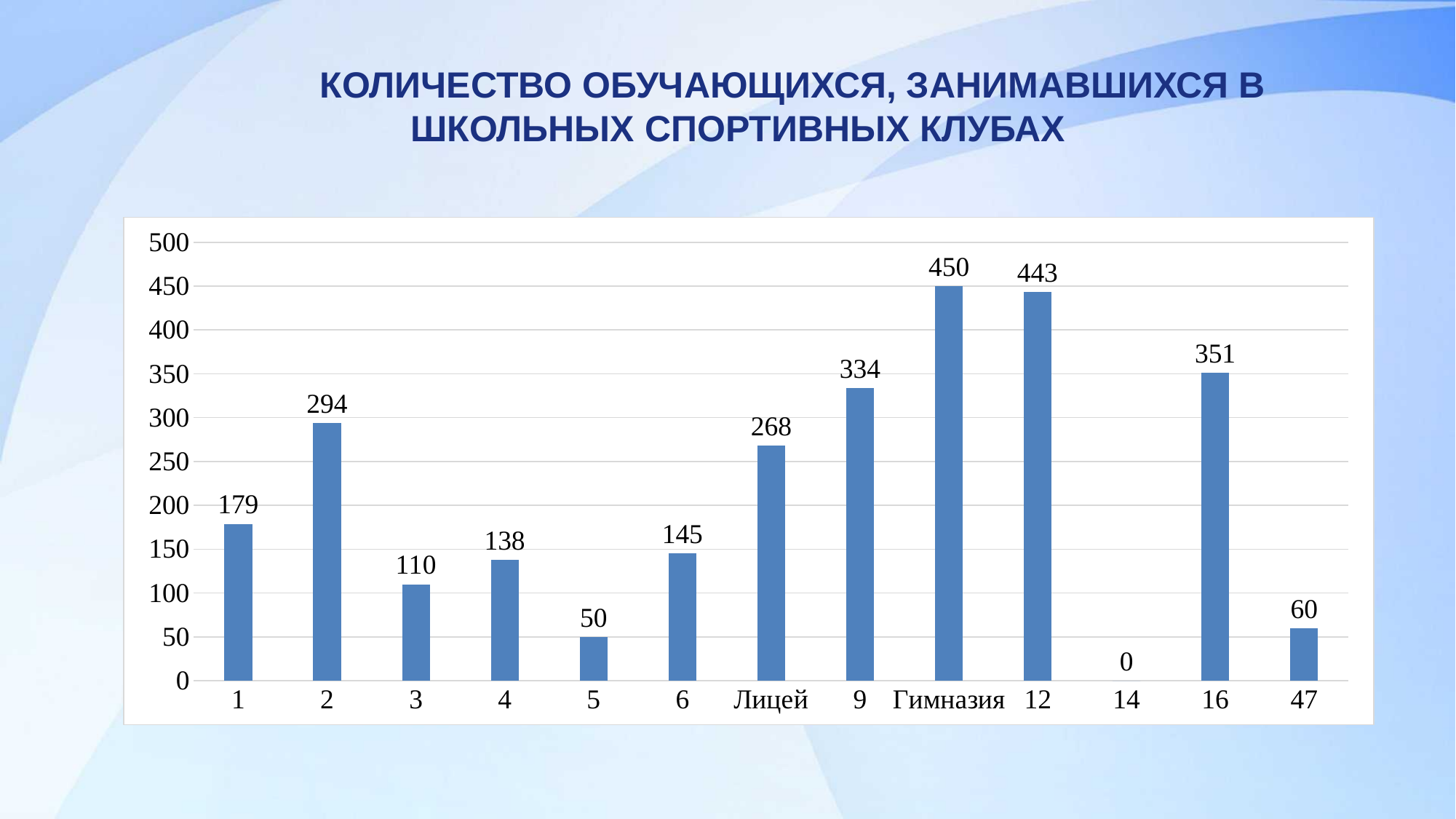
What is the value for Лицей? 268 What is the difference between the values for Гимназия and category 12? 7 What is the title of the slide? КОЛИЧЕСТВО ОБУЧАЮЩИХСЯ, ЗАНИМАВШИХСЯ В ШКОЛЬНЫХ СПОРТИВНЫХ КЛУБАХ How many categories are shown on the x axis? 13 Is the value for category 9 greater or less than 300? greater What is the value for category 2? 294 What kind of chart is shown on the slide? bar chart Which category has the lowest value? 14 What is the value for category 16? 351 Which category has the highest value? Гимназия What is the difference between the values for category 1 and category 47? 119 Which is larger, the value for category 4 or the value for category 6? 6